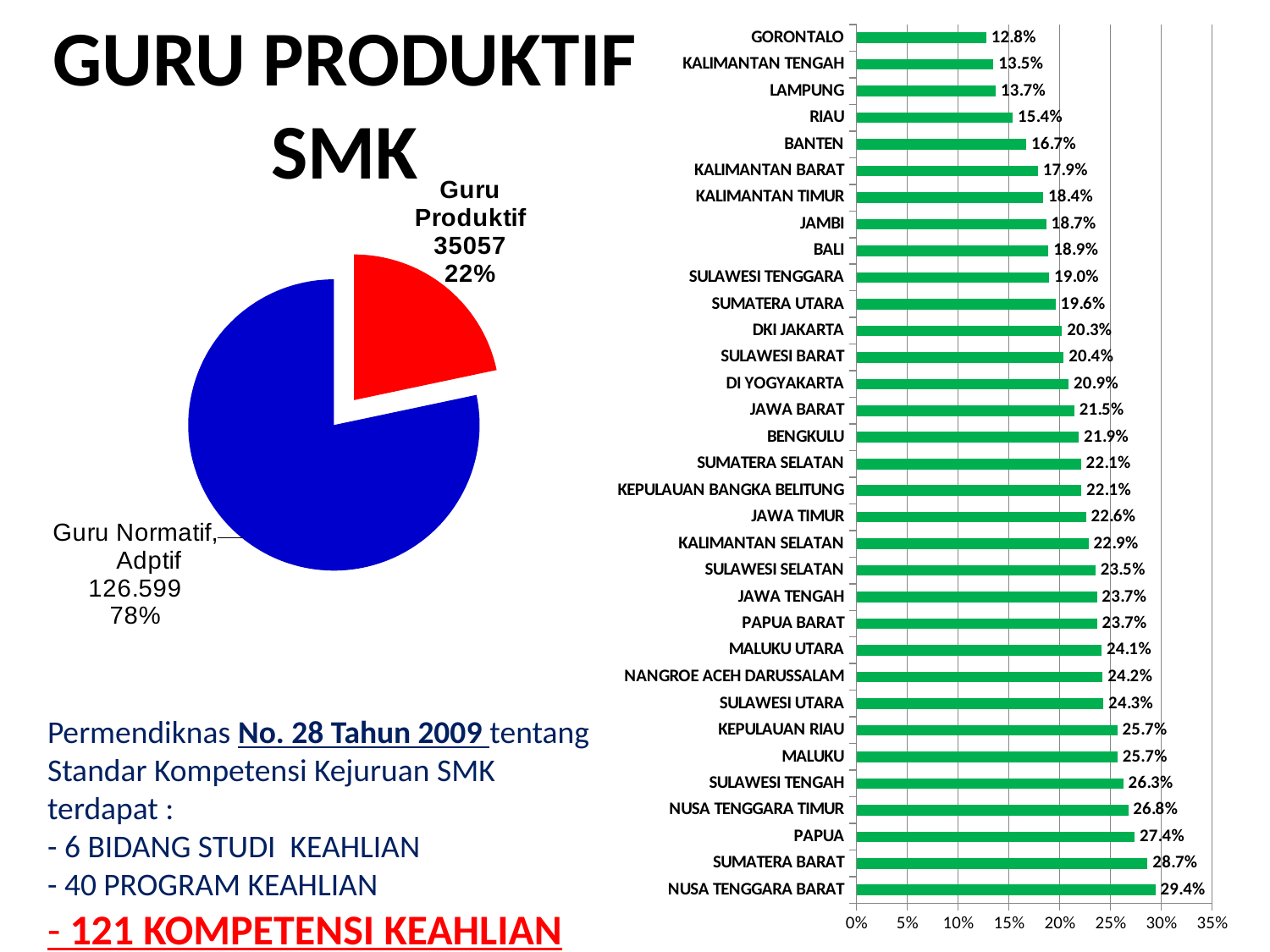
How many provinces are shown in the bar chart on the right? 33 In the bar chart on the right, what is the difference between the values for SUMATERA BARAT and GORONTALO? 15.9% In the bar chart on the right, what is the value for DKI JAKARTA? 20.3% In the pie chart on the left, what is the value shown for Guru Normatif, Adptif? 126.599 What kind of chart is the chart on the right of the slide? bar chart In the bar chart on the right, which is larger, the value for PAPUA or the value for BALI? PAPUA In the bar chart on the right, which province has the lowest value? GORONTALO In the pie chart on the left, what colour is the Guru Produktif slice? red In the bar chart on the right, which province has the highest value? NUSA TENGGARA BARAT In the bar chart on the right, what is the value for NUSA TENGGARA BARAT? 29.4% In the pie chart on the left, what share of the pie is Guru Produktif? 22% In the bar chart on the right, is the value for KEPULAUAN RIAU greater or less than 25%? greater